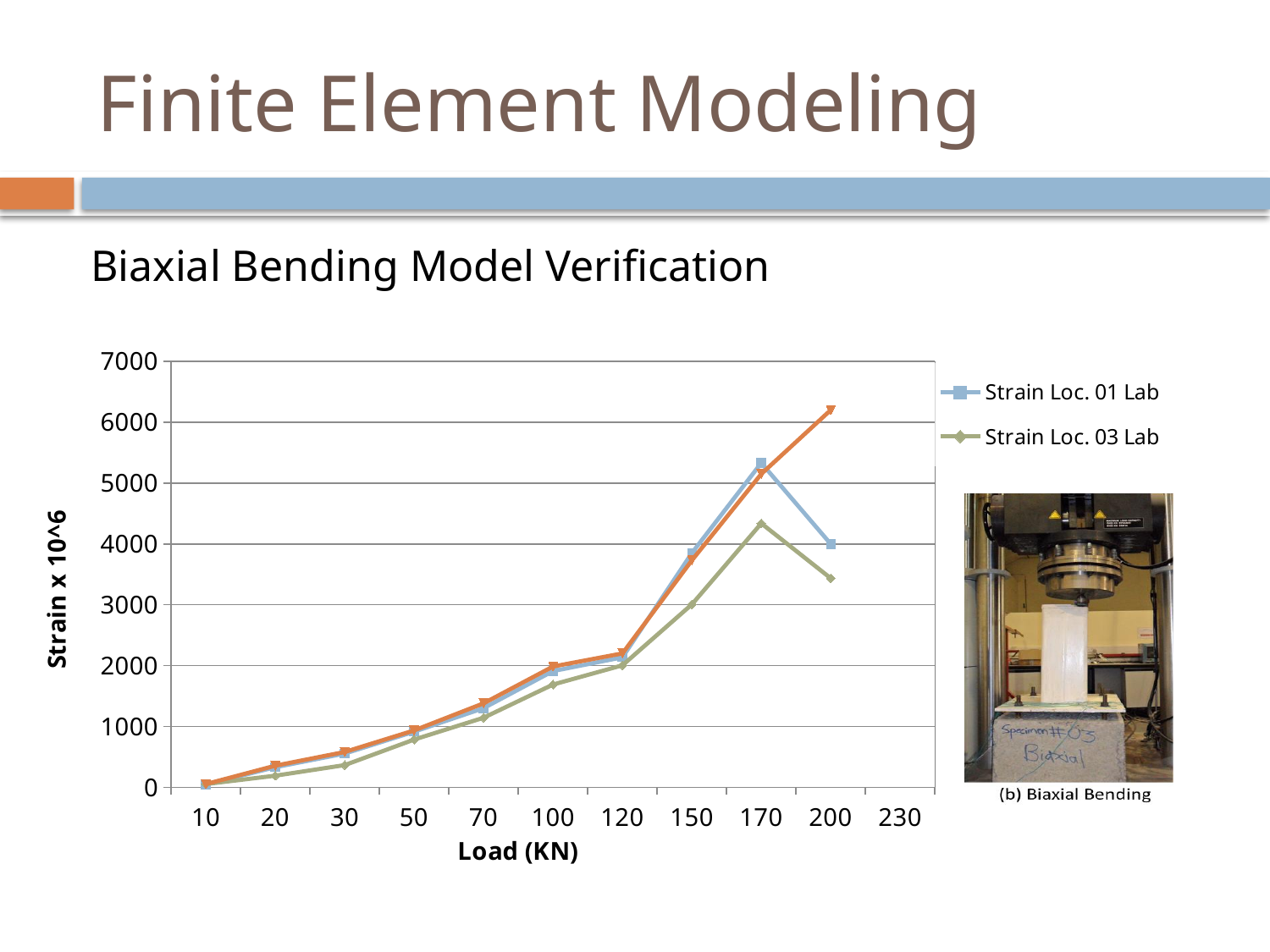
Is the value for Strain Loc. 01 Lab at a load of 70 greater or less than 1000? greater How many load values are labelled on the x axis? 11 At which load does Strain Loc. 01 Lab reach its highest value? 170 At a load of 170, which series has the larger value, Strain Loc. 01 Lab or Strain Loc. 03 Lab? Strain Loc. 01 Lab How many series does the chart's legend list? 2 What is the title of the chart's x axis? Load (KN) At a load of 200, which series has the larger value, Strain Loc. 01 Lab or Strain Loc. 03 Lab? Strain Loc. 01 Lab Is the value for Strain Loc. 03 Lab at a load of 200 greater or less than 4000? less Does the Strain Loc. 03 Lab series rise or fall as the load increases from 10 to 170? rise Is the value for Strain Loc. 03 Lab at a load of 30 greater or less than 1000? less What kind of chart is shown on the slide? line chart